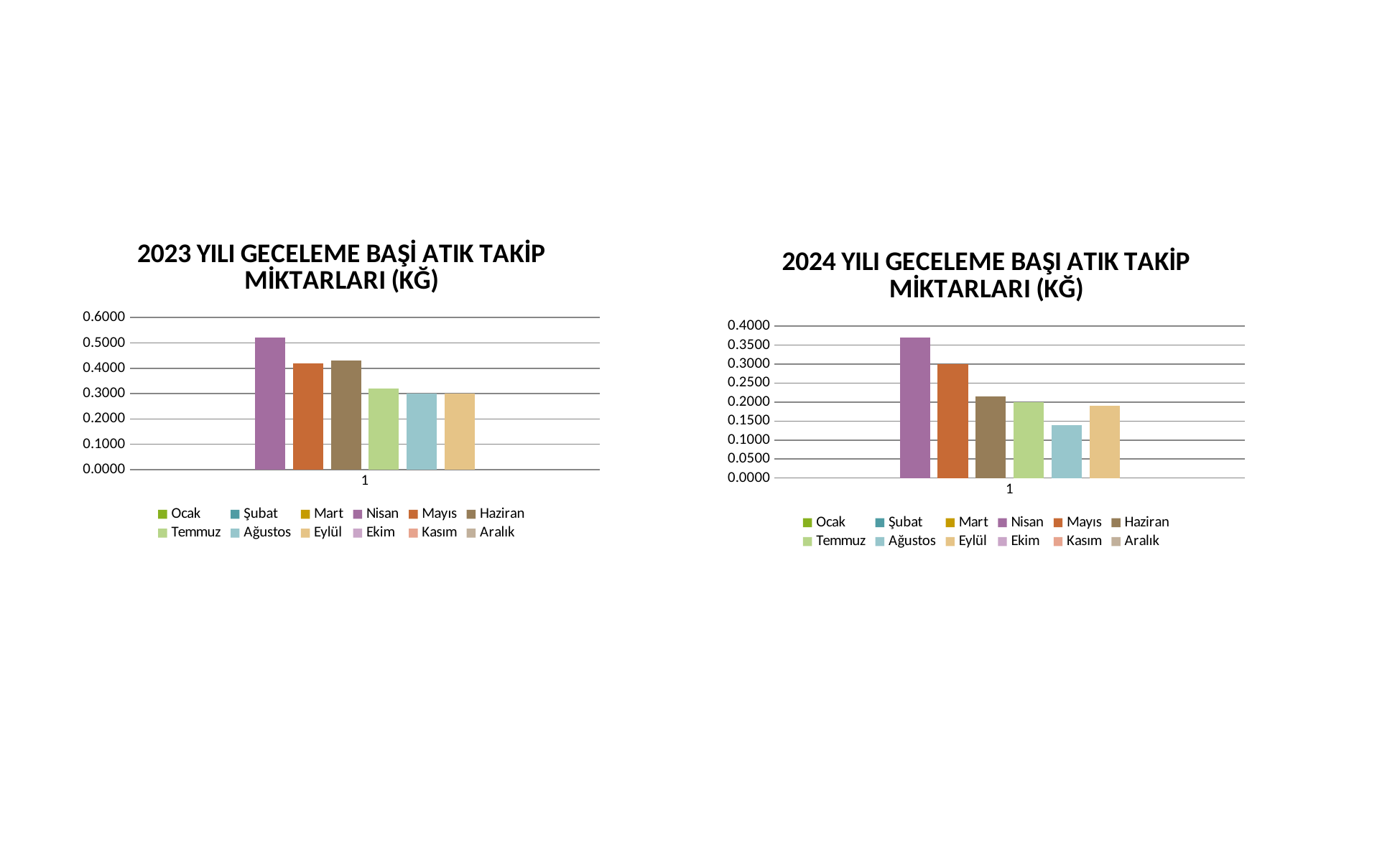
How many series does the legend of the "2024 YILI GECELEME BAŞI ATIK TAKİP MİKTARLARI (KĞ)" chart list? 12 In the 2023 chart, is the value for Haziran greater or less than 0.5000? less In the 2024 chart, which month has the lowest bar? Ağustos In the 2024 chart, which is larger, the value for Mayıs or the value for Haziran? Mayıs In the 2024 chart, which month has the highest bar? Nisan How many bars are plotted in the 2023 chart? 6 In the 2023 chart, is the value for Nisan greater or less than 0.4000? greater What kind of chart is the "2023 YILI GECELEME BAŞİ ATIK TAKİP MİKTARLARI (KĞ)" chart? bar chart In the 2023 chart, which month has the highest bar? Nisan In the 2024 chart, is the value for Ağustos greater or less than 0.2000? less In the 2023 chart, which is larger, the value for Nisan or the value for Mayıs? Nisan